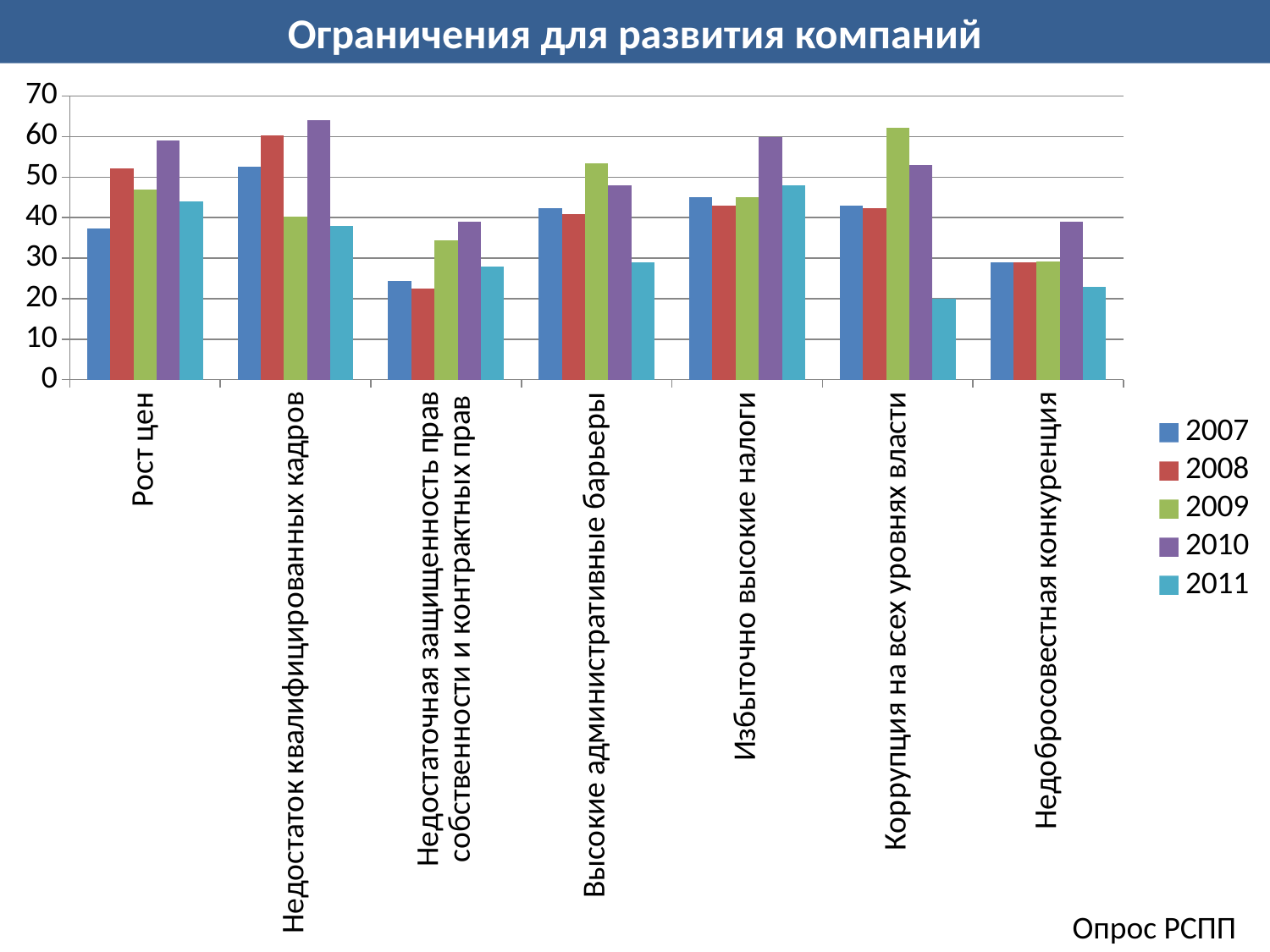
Is the 2007 value for Рост цен greater or less than 40? less How many categories are shown on the x axis? 7 Is the 2010 value for Недостаток квалифицированных кадров greater or less than 60? greater Is the 2011 value for Коррупция на всех уровнях власти greater or less than 30? less Which category has the highest 2010 value? Недостаток квалифицированных кадров What kind of chart is shown on the slide? Bar chart For Коррупция на всех уровнях власти, which is larger: the 2009 value or the 2010 value? 2009 What is the title of the chart? Ограничения для развития компаний Which category has the lowest 2008 value? Недостаточная защищенность прав собственности и контрактных прав How many series does the legend list? 5 What source is cited at the bottom right of the slide? Опрос РСПП For Рост цен, which is larger: the 2008 value or the 2009 value? 2008